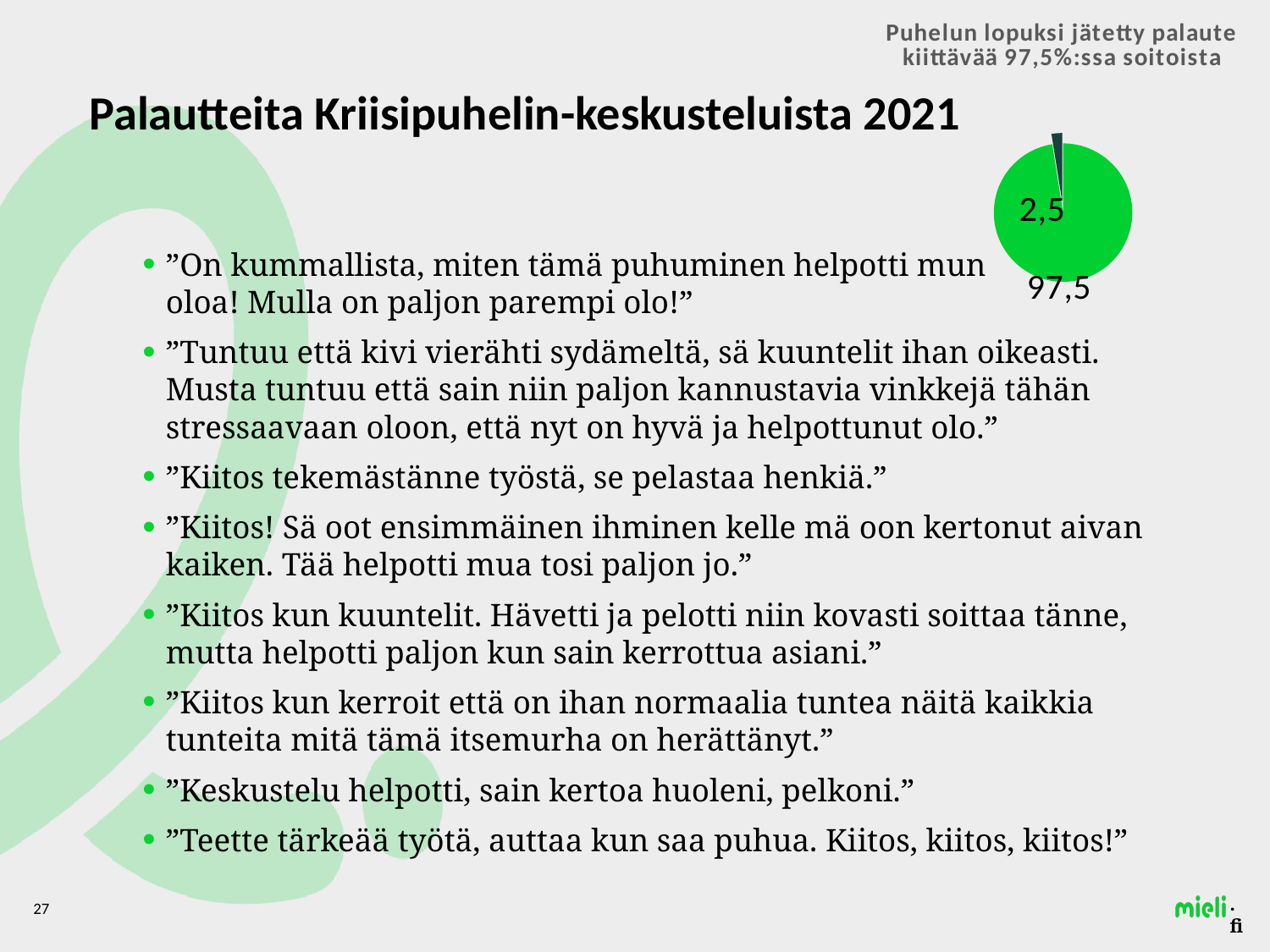
How many slices does the pie chart have? 2 What is the largest value shown in the pie chart? 97,5 Is the value of the dark slice greater or less than 10? less What colour is the slice labelled 97,5 in the pie chart? green Which slice of the pie chart is larger, the green one or the dark one? the green one What kind of chart is shown on the slide? pie chart What is the difference between the two values in the pie chart? 95 What is the smallest value shown in the pie chart? 2,5 What is the value of the small dark slice of the pie chart? 2,5 What do the two values in the pie chart add up to? 100 Is the value of the green slice greater or less than 90? greater What is the value of the large green slice of the pie chart? 97,5